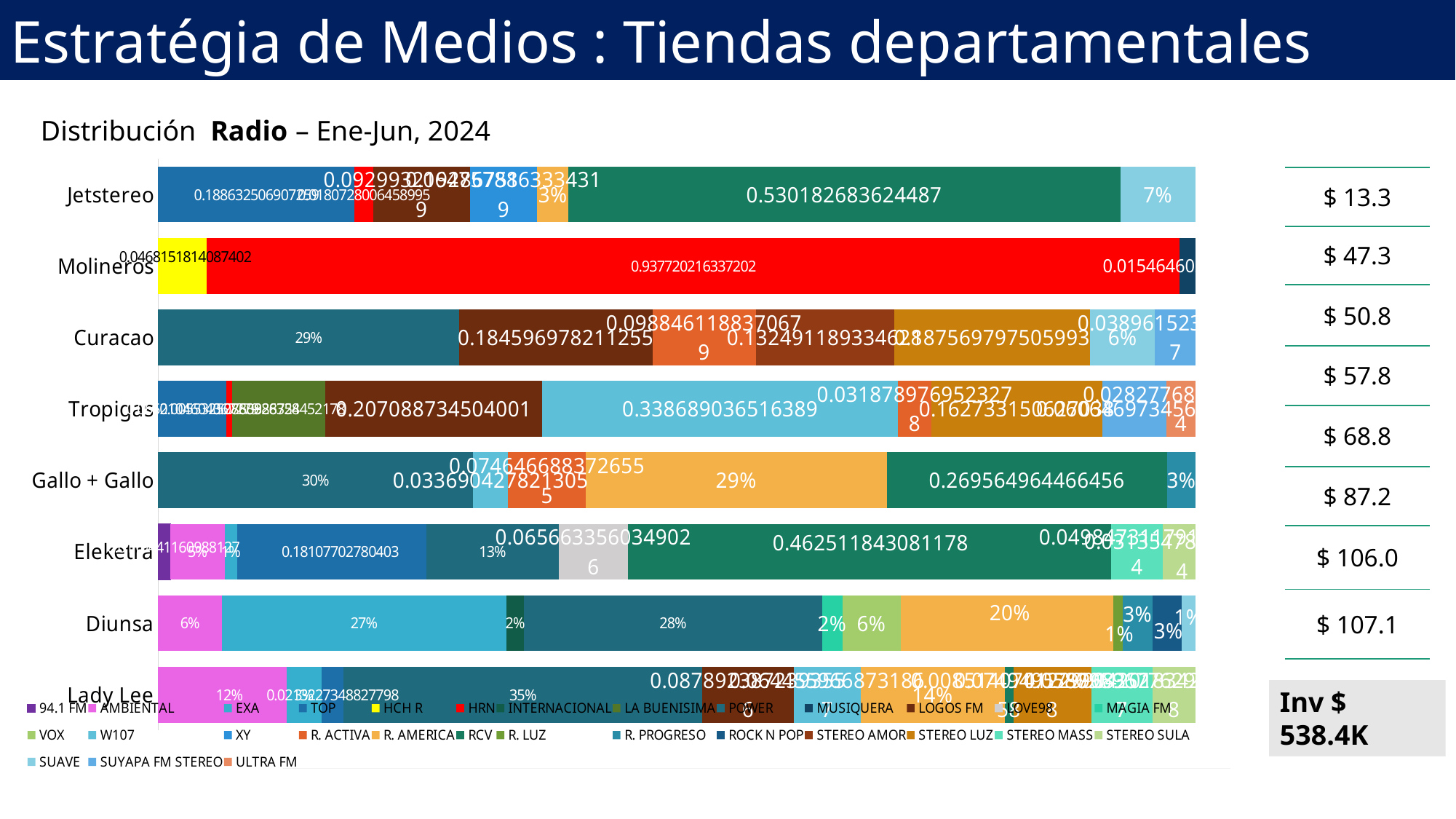
How many store categories are plotted on the chart? 8 What is the value of the HRN (red) segment in the Molineros bar? 0.937720216337202 What is the largest labelled segment in the Diunsa bar? 28% How many series does the legend list? 29 What kind of chart is shown on the slide? bar chart What is the value of the first segment in the Gallo + Gallo bar? 30% What is the difference between the 28% and 27% segments in the Diunsa bar? 1% Which is larger: the HRN segment for Molineros (0.937720216337202) or the RCV segment for Jetstereo (0.530182683624487)? Molineros HRN segment What is the value of the SUAVE (light blue) segment at the end of the Jetstereo bar? 7% What is the value of the first segment in the Curacao bar? 29% What is the value of the HCH R (yellow) segment in the Molineros bar? 0.0468151814087402 What is the title of the chart? Distribución Radio – Ene-Jun, 2024